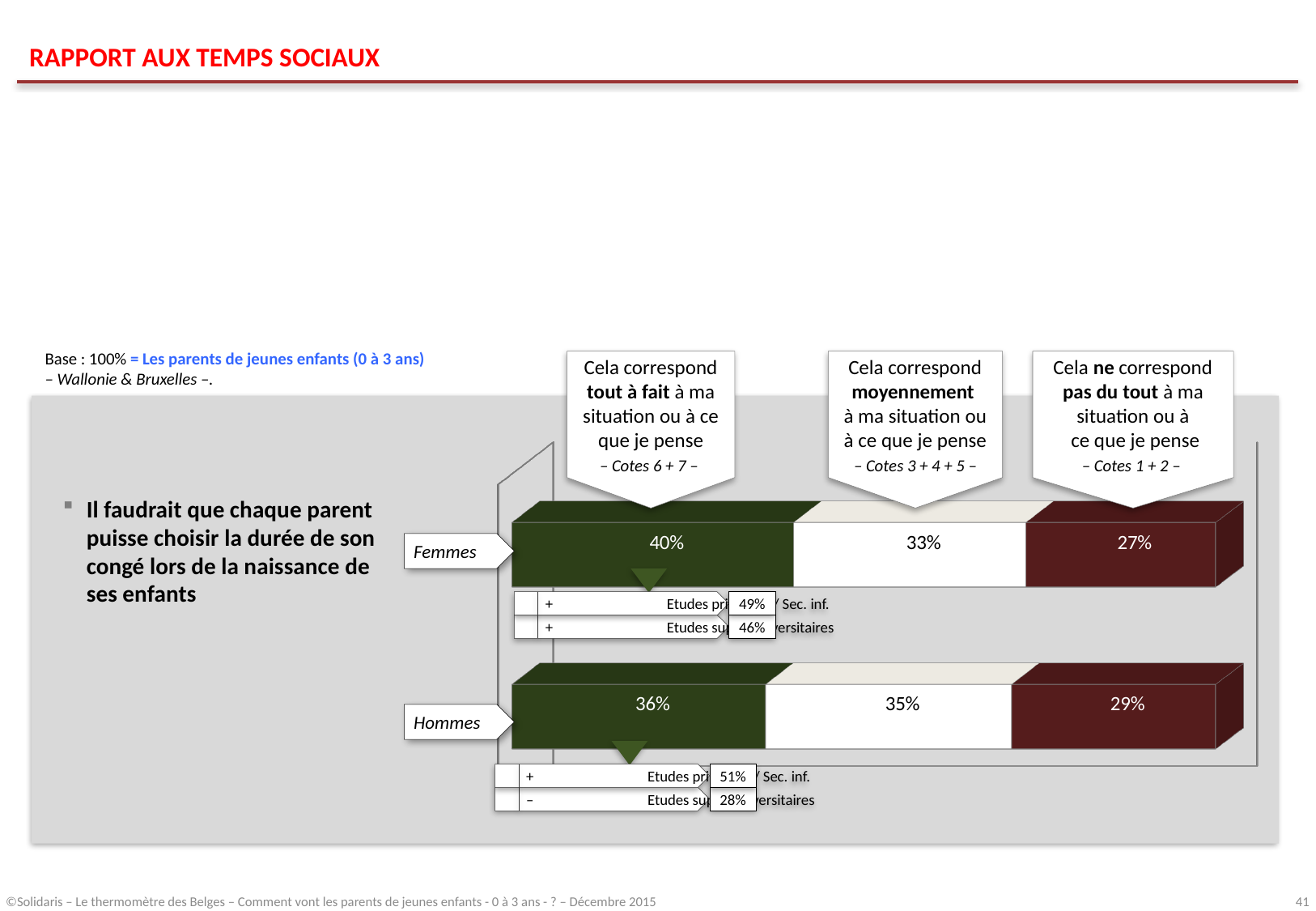
Which segment is the smallest for Hommes? Cela ne correspond pas du tout (29%) What kind of chart is shown on the slide? Stacked bar chart What is the total of the three segments in the Femmes bar? 100% Which segment is the largest for Femmes? Cela correspond tout à fait (40%) What is the 'tout à fait' percentage for Hommes with 'Etudes supérieures / universitaires'? 28% How many groups (bars) are shown in the chart? 2 What is the difference between the 'tout à fait' share for Femmes and for Hommes? 4 percentage points What percentage of Hommes say the statement 'ne correspond pas du tout' to their situation? 29% What percentage of Hommes say the statement corresponds 'tout à fait' to their situation? 36% What percentage of Femmes say the statement corresponds 'moyennement' to their situation? 33% What percentage of Femmes say the statement corresponds 'tout à fait' to their situation? 40% Which group has the larger 'pas du tout' share, Femmes or Hommes? Hommes